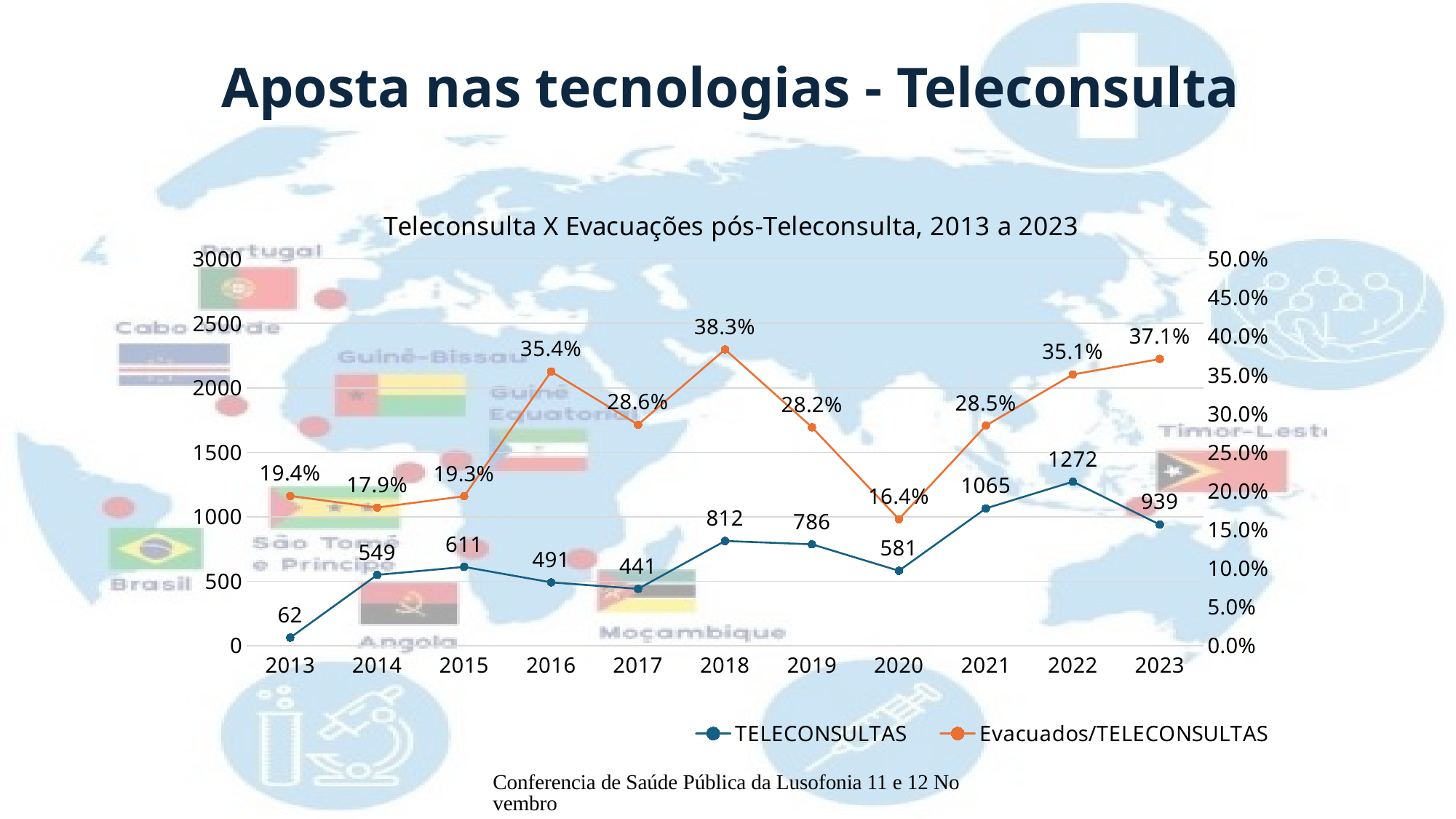
What is the value of TELECONSULTAS in 2013? 62 What is the value of TELECONSULTAS in 2022? 1272 How many series does the legend list? 2 In which year is the TELECONSULTAS value highest? 2022 How many years are shown on the x axis? 11 In which year is the Evacuados/TELECONSULTAS value lowest? 2020 What kind of chart is shown on the slide? Line chart What is the value of Evacuados/TELECONSULTAS in 2018? 38.3% What is the title of the chart? Teleconsulta X Evacuações pós-Teleconsulta, 2013 a 2023 What is the value of Evacuados/TELECONSULTAS in 2020? 16.4% Which year has a higher TELECONSULTAS value, 2018 or 2019? 2018 What is the difference between the TELECONSULTAS values for 2022 and 2023? 333